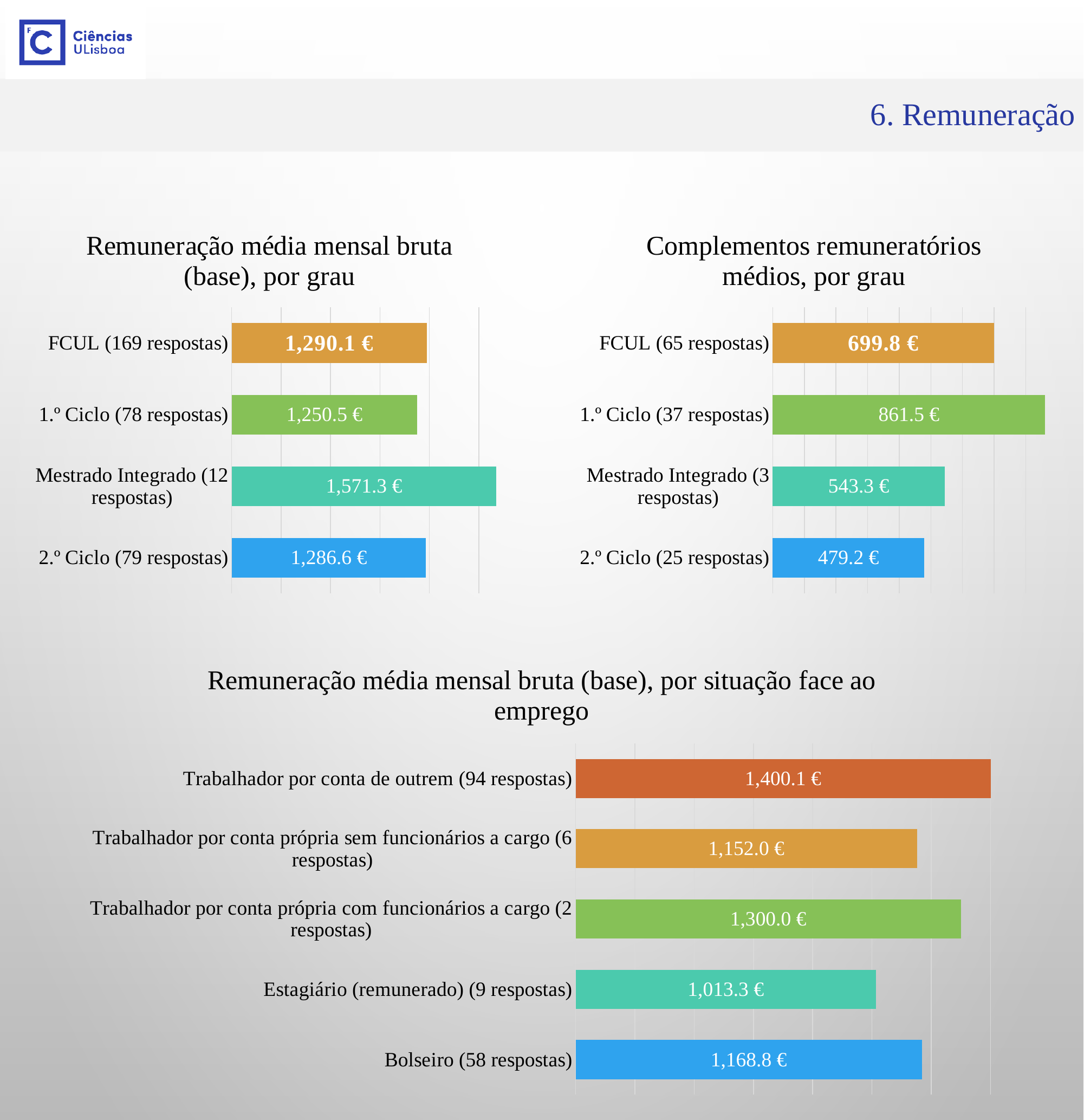
In the chart 'Complementos remuneratórios médios, por grau', what is the value for FCUL (65 respostas)? 699.8 € In the chart 'Remuneração média mensal bruta (base), por situação face ao emprego', which category has the lowest value? Estagiário (remunerado) (9 respostas) In the chart 'Complementos remuneratórios médios, por grau', which category has the lowest value? 2.º Ciclo (25 respostas) In the chart 'Remuneração média mensal bruta (base), por situação face ao emprego', how many categories are shown? 5 In the chart 'Complementos remuneratórios médios, por grau', which is larger: Mestrado Integrado or 2.º Ciclo? Mestrado Integrado What kind of chart is 'Remuneração média mensal bruta (base), por situação face ao emprego'? Bar chart In the chart 'Remuneração média mensal bruta (base), por situação face ao emprego', what is the value for Bolseiro (58 respostas)? 1,168.8 € In the chart 'Remuneração média mensal bruta (base), por grau', what is the value for Mestrado Integrado (12 respostas)? 1,571.3 € In the chart 'Complementos remuneratórios médios, por grau', which category has the highest value? 1.º Ciclo (37 respostas) In the chart 'Remuneração média mensal bruta (base), por grau', which category has the highest value? Mestrado Integrado (12 respostas) In the chart 'Remuneração média mensal bruta (base), por grau', which category has the lowest value? 1.º Ciclo (78 respostas) In the chart 'Remuneração média mensal bruta (base), por grau', what is the difference between Mestrado Integrado and 1.º Ciclo? 320.8 €